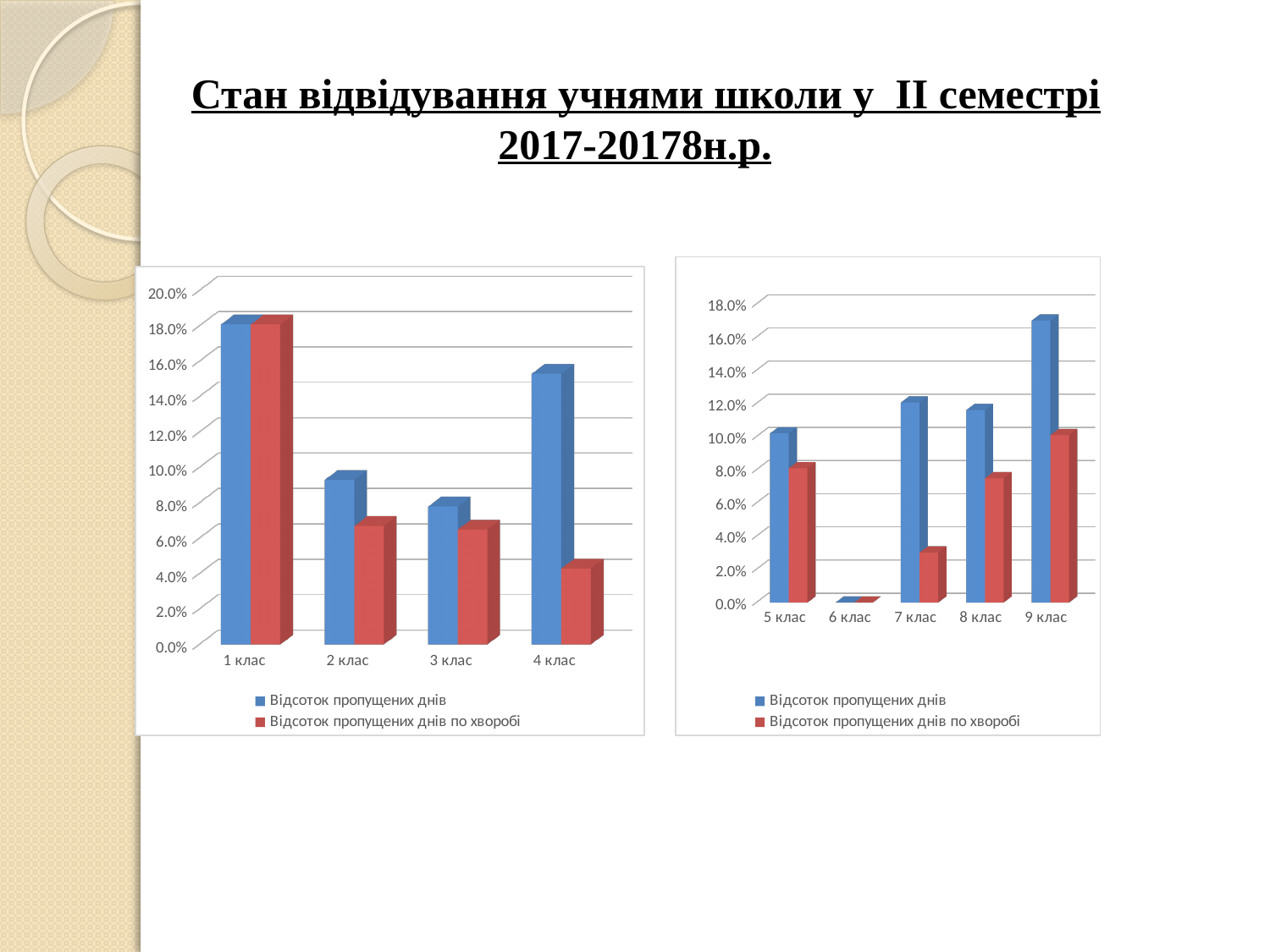
On the left chart, which class has the highest value for 'Відсоток пропущених днів'? 1 клас How many series does the legend of the right chart list? 2 How many classes (categories) are shown on the right chart? 5 What kind of chart is the left chart? bar chart On the right chart, is the value of 'Відсоток пропущених днів' for 9 клас greater or less than 16.0%? greater On the left chart, which class has the lowest value for 'Відсоток пропущених днів по хворобі'? 4 клас On the left chart, is the value of 'Відсоток пропущених днів' for 4 клас greater or less than 14.0%? greater How many classes (categories) are shown on the left chart? 4 On the right chart, which class has the lowest value for 'Відсоток пропущених днів по хворобі'? 6 клас On the right chart, is the value of 'Відсоток пропущених днів по хворобі' for 7 клас greater or less than 4.0%? less On the left chart, which class has the larger value for 'Відсоток пропущених днів': 2 клас or 3 клас? 2 клас On the right chart, which class has the highest value for 'Відсоток пропущених днів'? 9 клас